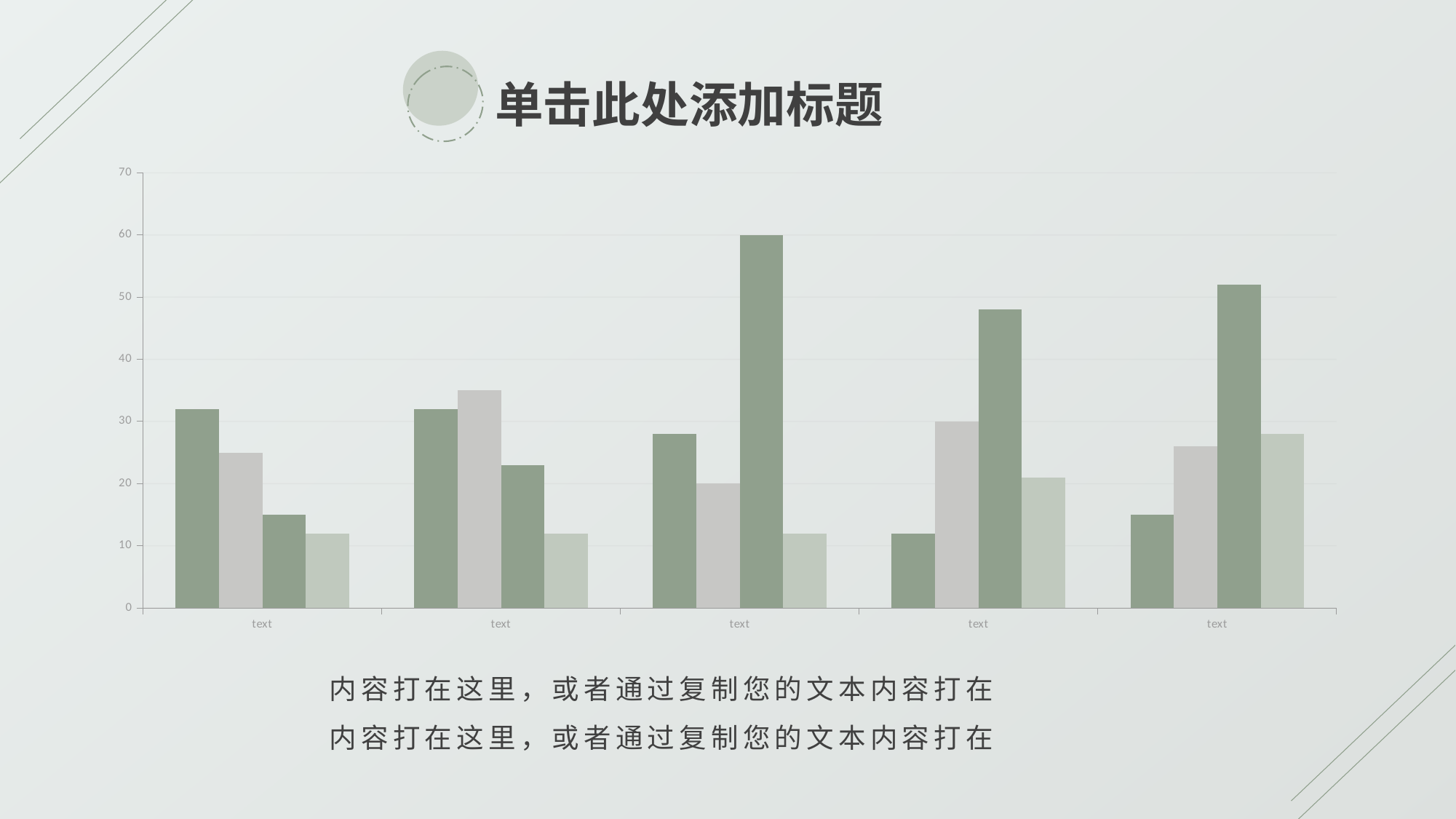
Which category group contains the tallest bar in the chart? the third group In the third category group, which is taller: the first bar or the third bar? the third bar How many category groups are shown along the x axis of the chart? 5 Is the value of the third bar in the fifth category group greater or less than 40? greater Is the value of the third bar in the fourth category group greater or less than 40? greater What label is shown under each category group on the x axis? text Is the value of the first bar in the fourth category group greater or less than 20? less What is the highest value shown on the chart's y axis? 70 What kind of chart is shown on the slide? bar chart How many bars are there in each category group of the chart? 4